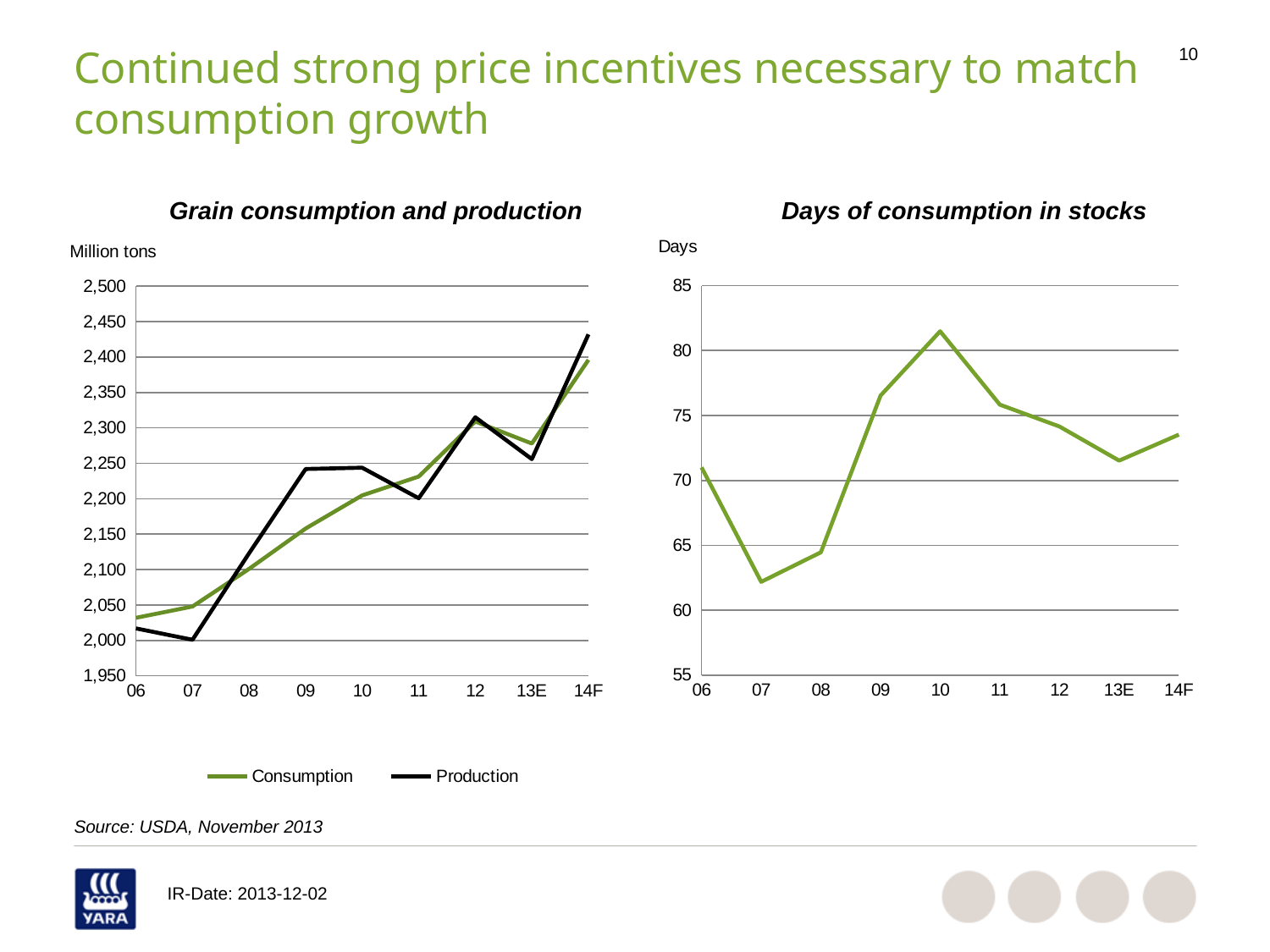
In the 'Days of consumption in stocks' chart, which year has the highest value? 10 In the 'Days of consumption in stocks' chart, is the value for 10 greater or less than 80? greater In the 'Days of consumption in stocks' chart, is the value for 07 greater or less than 65? less How many points are plotted along the x axis of the 'Days of consumption in stocks' chart? 9 What unit is shown on the y axis of the 'Grain consumption and production' chart? Million tons What kind of chart is the 'Grain consumption and production' chart? line chart In the 'Grain consumption and production' chart, which series is higher in 09, Consumption or Production? Production In the 'Grain consumption and production' chart, which series is higher in 11, Consumption or Production? Consumption In the 'Grain consumption and production' chart, is the Production value for 14F greater or less than 2,400? greater In the 'Days of consumption in stocks' chart, do the values rise or fall from 10 to 13E? fall In the 'Days of consumption in stocks' chart, which year has the lowest value? 07 How many series does the legend of the 'Grain consumption and production' chart list? 2